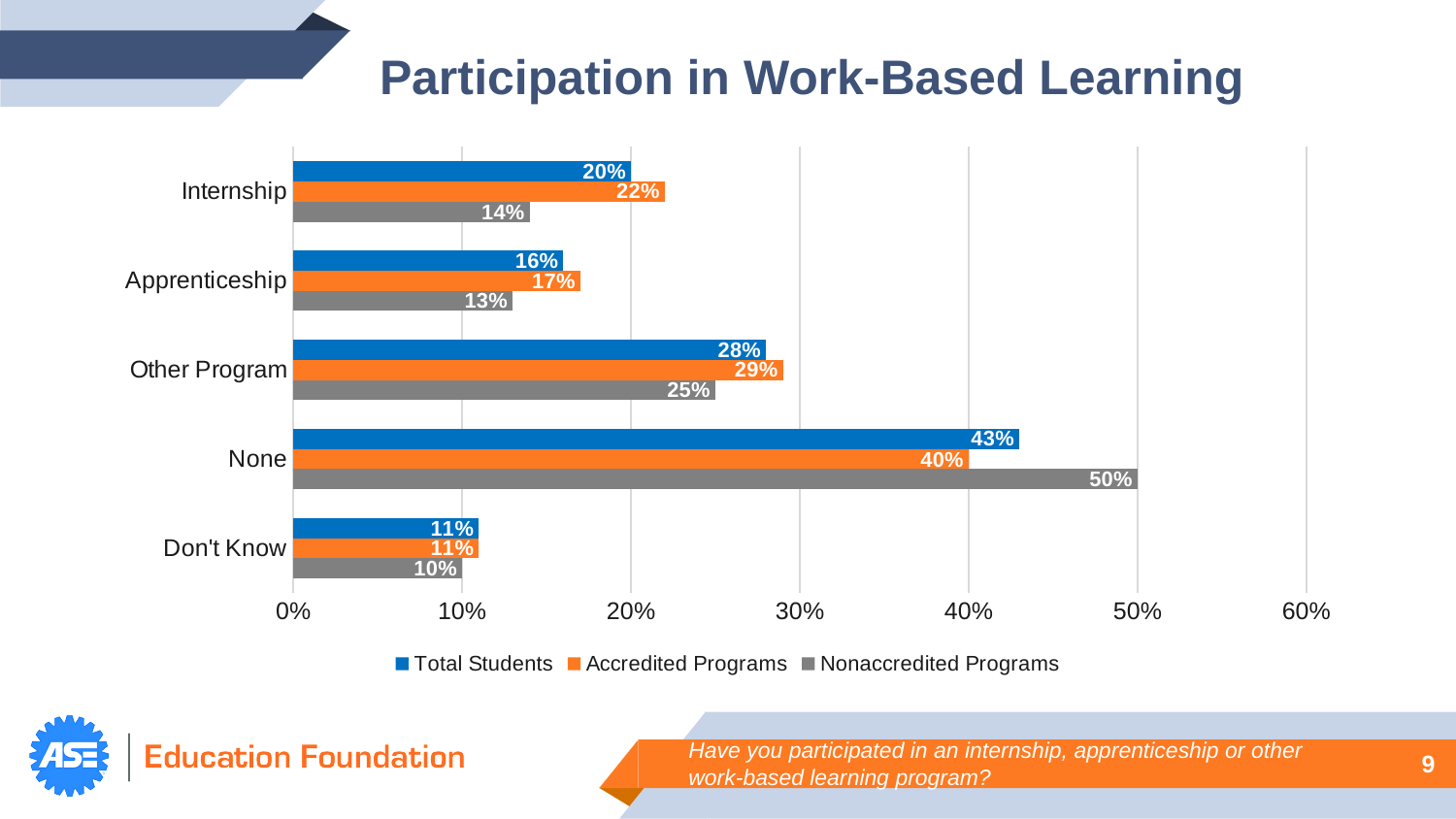
Which category has the highest value for Total Students? None What is the value for Accredited Programs in the Apprenticeship category? 17% Which category has the lowest value for Nonaccredited Programs? Don't Know How many categories are shown on the chart? 5 In the Other Program category, which is larger: Accredited Programs or Nonaccredited Programs? Accredited Programs What is the value for Total Students in the Internship category? 20% Which colour represents Nonaccredited Programs in the legend? Gray What is the difference between Nonaccredited Programs and Accredited Programs in the None category? 10% What is the title of the chart? Participation in Work-Based Learning How many series does the legend list? 3 What is the value for Nonaccredited Programs in the None category? 50% What kind of chart is shown on the slide? Bar chart